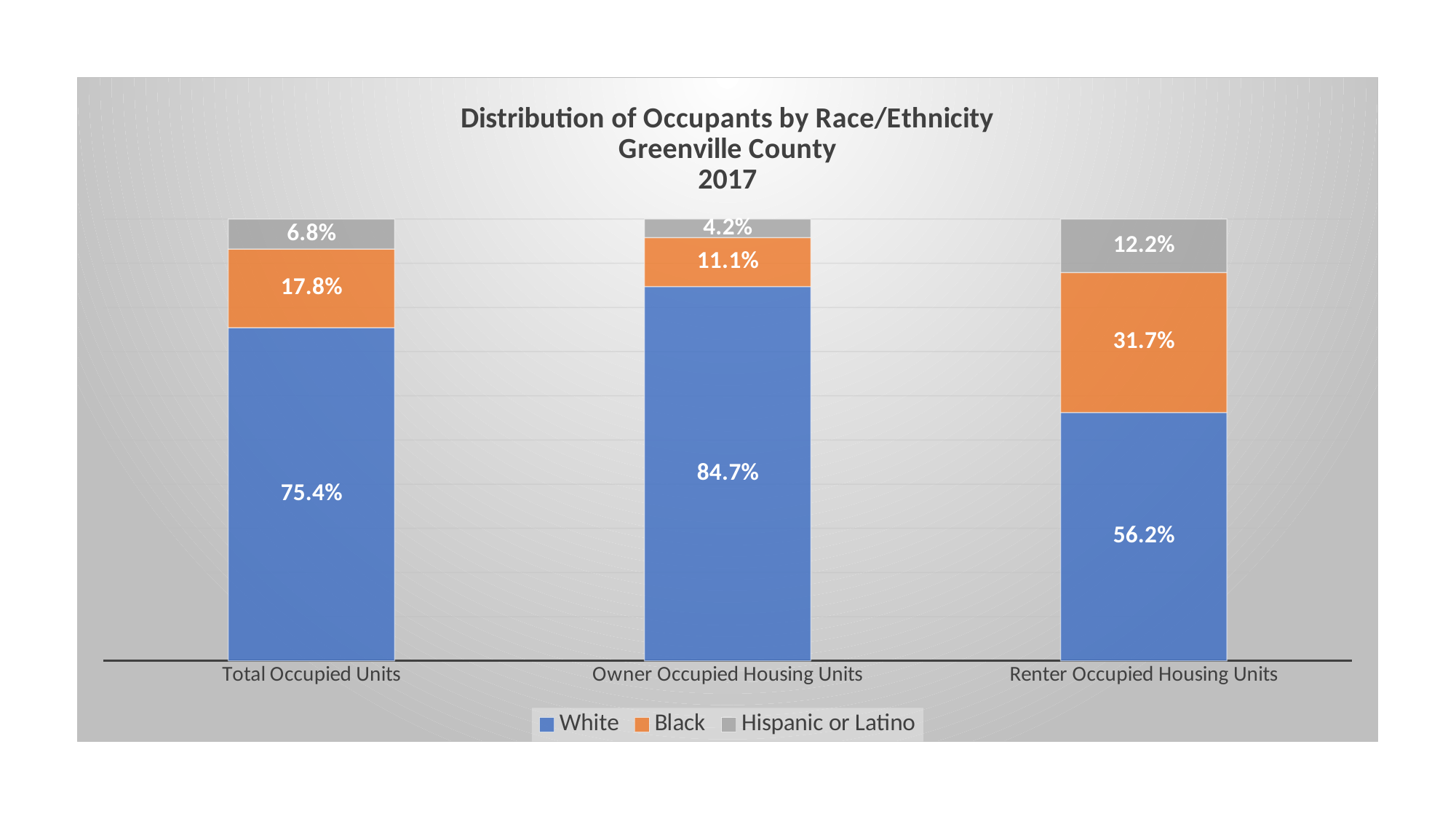
Which category has the highest White share? Owner Occupied Housing Units Which colour represents the Black series in the legend? Orange What is the Black share for Renter Occupied Housing Units? 31.7% What is the difference between the Black share for Renter Occupied Housing Units and for Owner Occupied Housing Units? 20.6% What is the White share for Owner Occupied Housing Units? 84.7% Which is larger: the White share for Total Occupied Units or for Renter Occupied Housing Units? Total Occupied Units What kind of chart is shown? Stacked bar chart What is the total of the stacked bar for Renter Occupied Housing Units? 100.1% How many series does the legend list? 3 What is the Hispanic or Latino share for Total Occupied Units? 6.8% Which category has the lowest Hispanic or Latino share? Owner Occupied Housing Units How many categories are shown on the x axis? 3